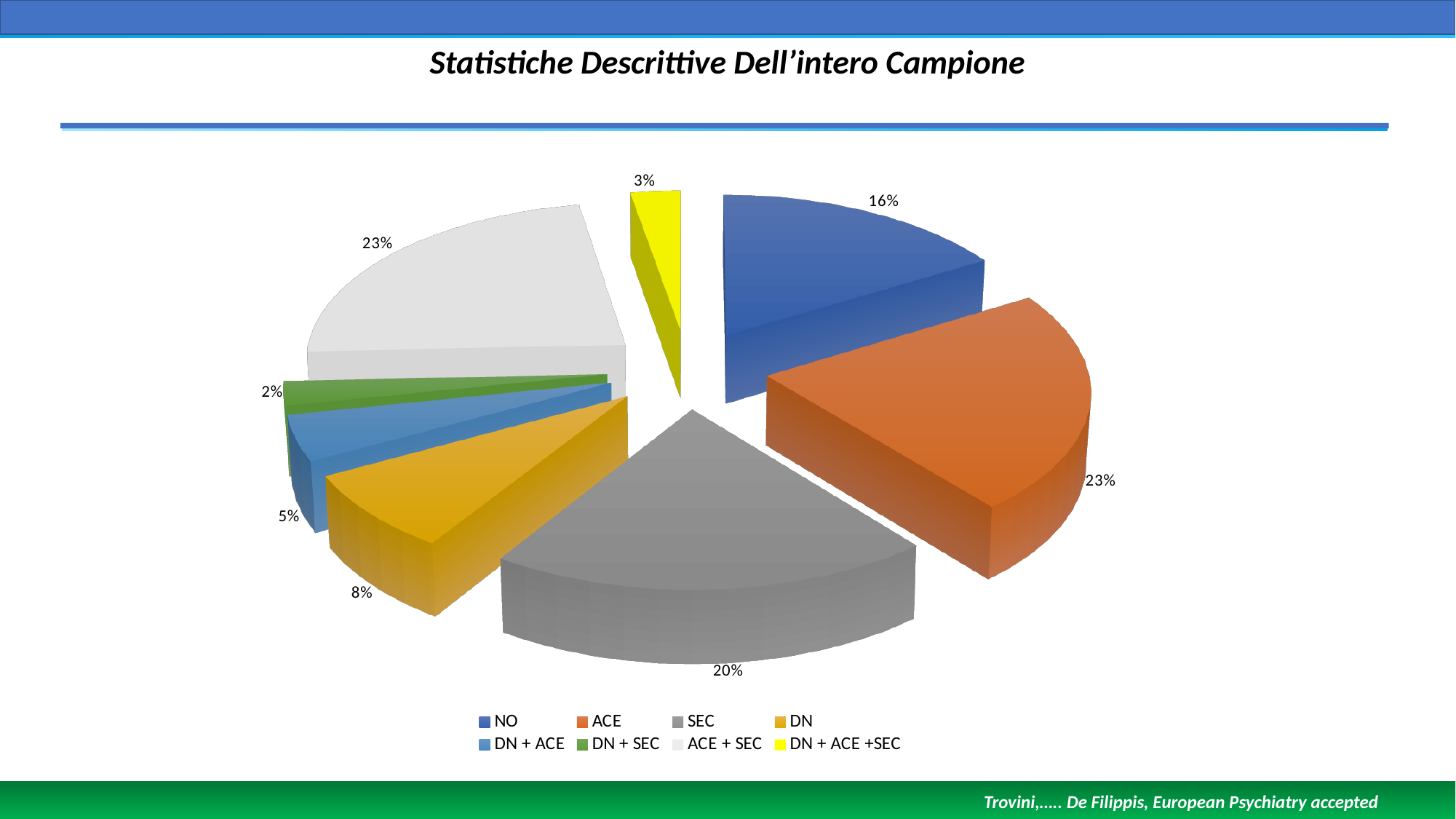
What share of the pie does the SEC slice represent? 20% What is the title of the slide containing the pie chart? Statistiche Descrittive Dell'intero Campione Which category has the smallest slice of the pie? DN + SEC How many categories does the legend list? 8 What is the value shown for the DN slice? 8% What percentage is shown for DN + ACE +SEC? 3% What kind of chart is shown on the slide? pie chart What is the difference in percentage points between the SEC slice and the DN slice? 12 Which is larger, the ACE slice or the NO slice? ACE What percentage of the sample is labelled NO? 16% What percentage is shown for DN + ACE? 5% What percentage is shown for ACE + SEC? 23%